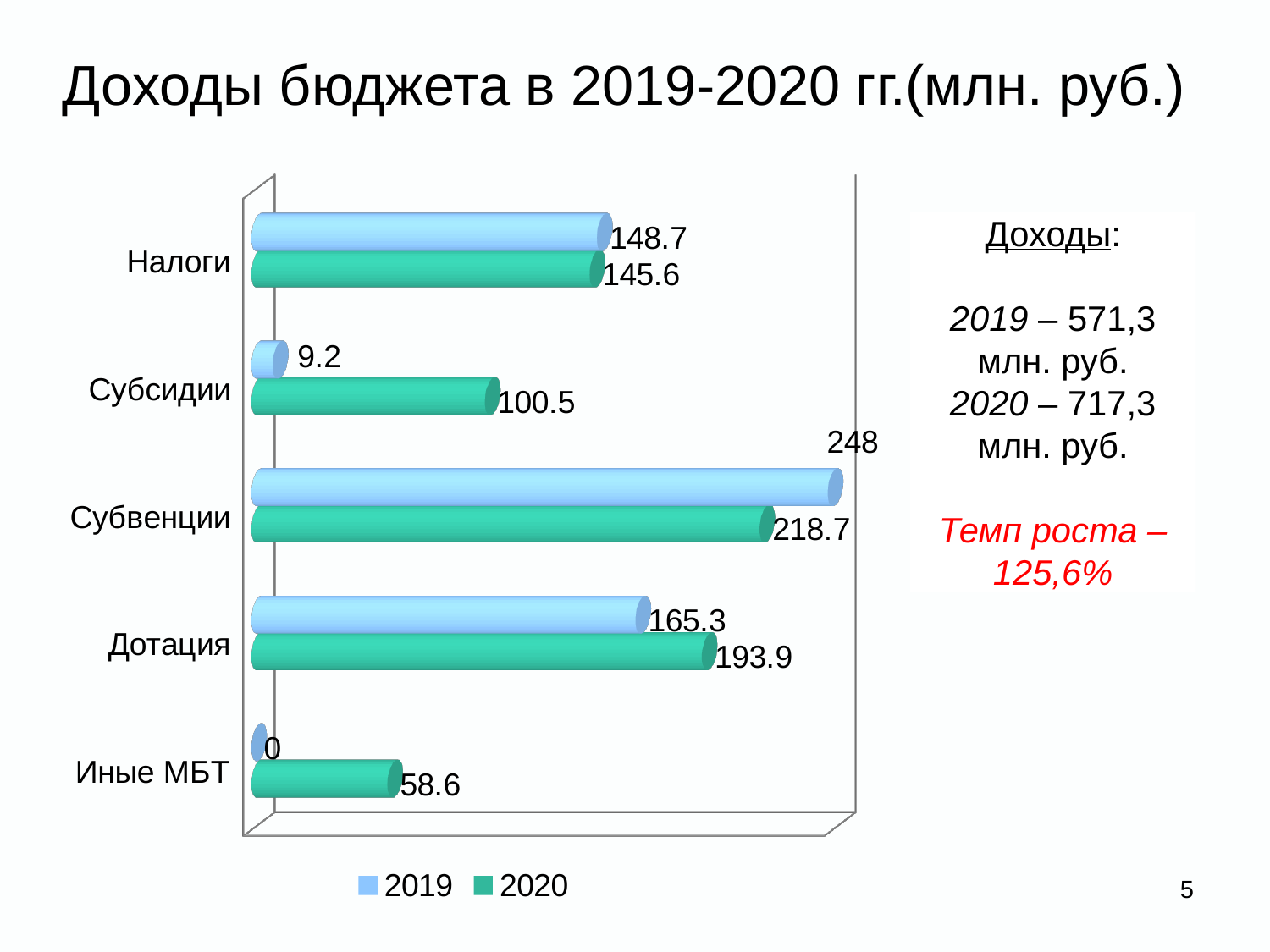
What is the value for Субсидии in the 2020 series? 100.5 Which is larger for Субсидии: the 2019 value or the 2020 value? 2020 How many series does the legend list? 2 What is the value for Налоги in the 2019 series? 148.7 What kind of chart is shown on the slide? bar chart Which category has the highest value in the 2019 series? Субвенции Which category has the lowest value in the 2020 series? Иные МБТ How many categories are shown on the chart? 5 What is the value for Иные МБТ in the 2019 series? 0 What is the difference between the 2020 and 2019 values for Дотация? 28.6 What is the title of the slide's chart? Доходы бюджета в 2019-2020 гг.(млн. руб.) What is the difference between the 2019 and 2020 values for Субвенции? 29.3